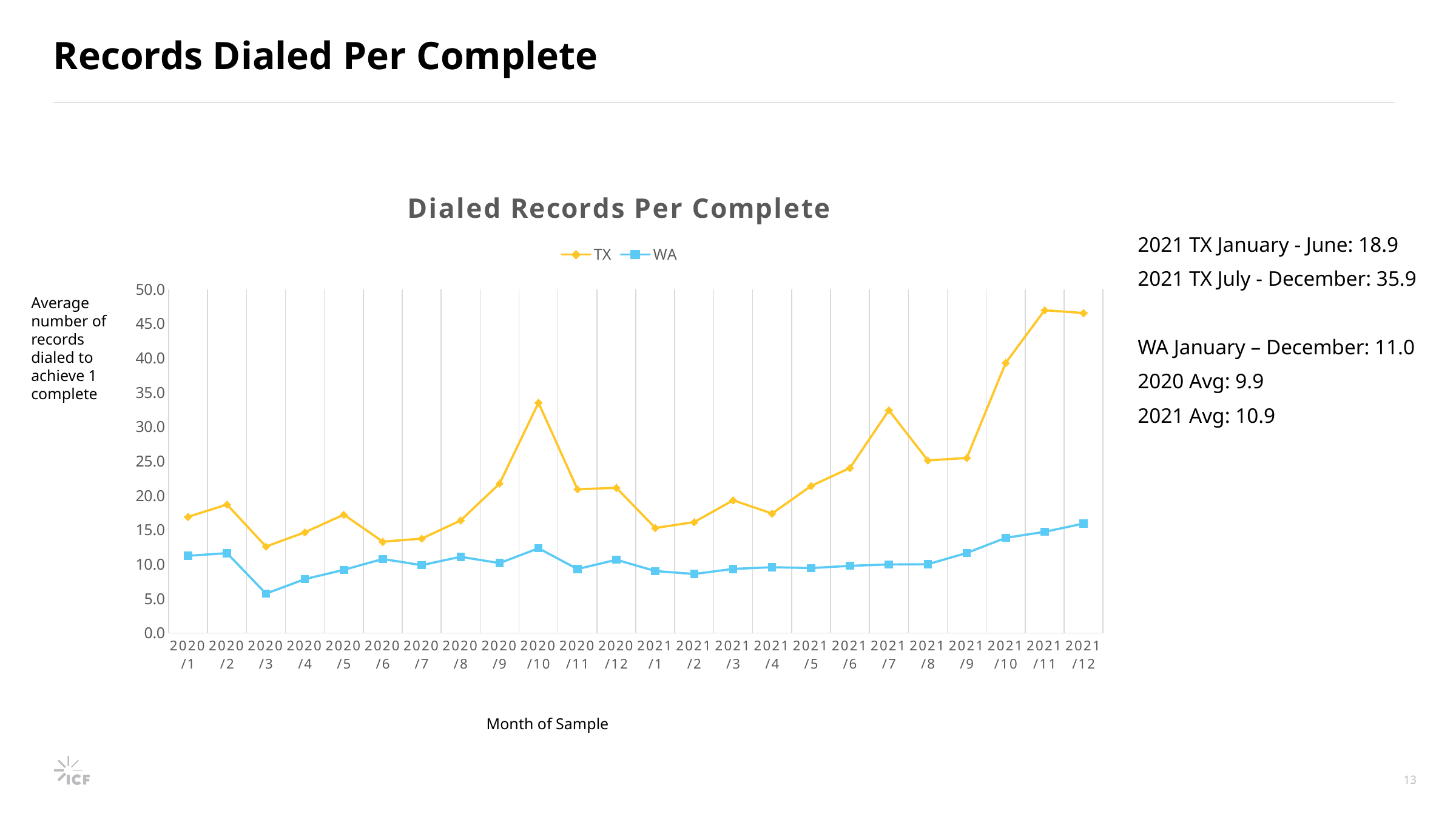
What kind of chart is shown on the slide? line chart What is the title of the chart? Dialed Records Per Complete How many series does the legend list? 2 Is the value for TX in 2020/10 greater or less than 30? greater Is the value for TX in 2020/3 greater or less than 15? less In 2021/12, which series has the larger value, TX or WA? TX Do the WA values rise or fall from 2021/8 to 2021/12? rise Which month has the highest value for WA? 2021/12 Which month has the lowest value for WA? 2020/3 Is the value for WA in 2020/3 greater or less than 10? less How many months are plotted along the x axis? 24